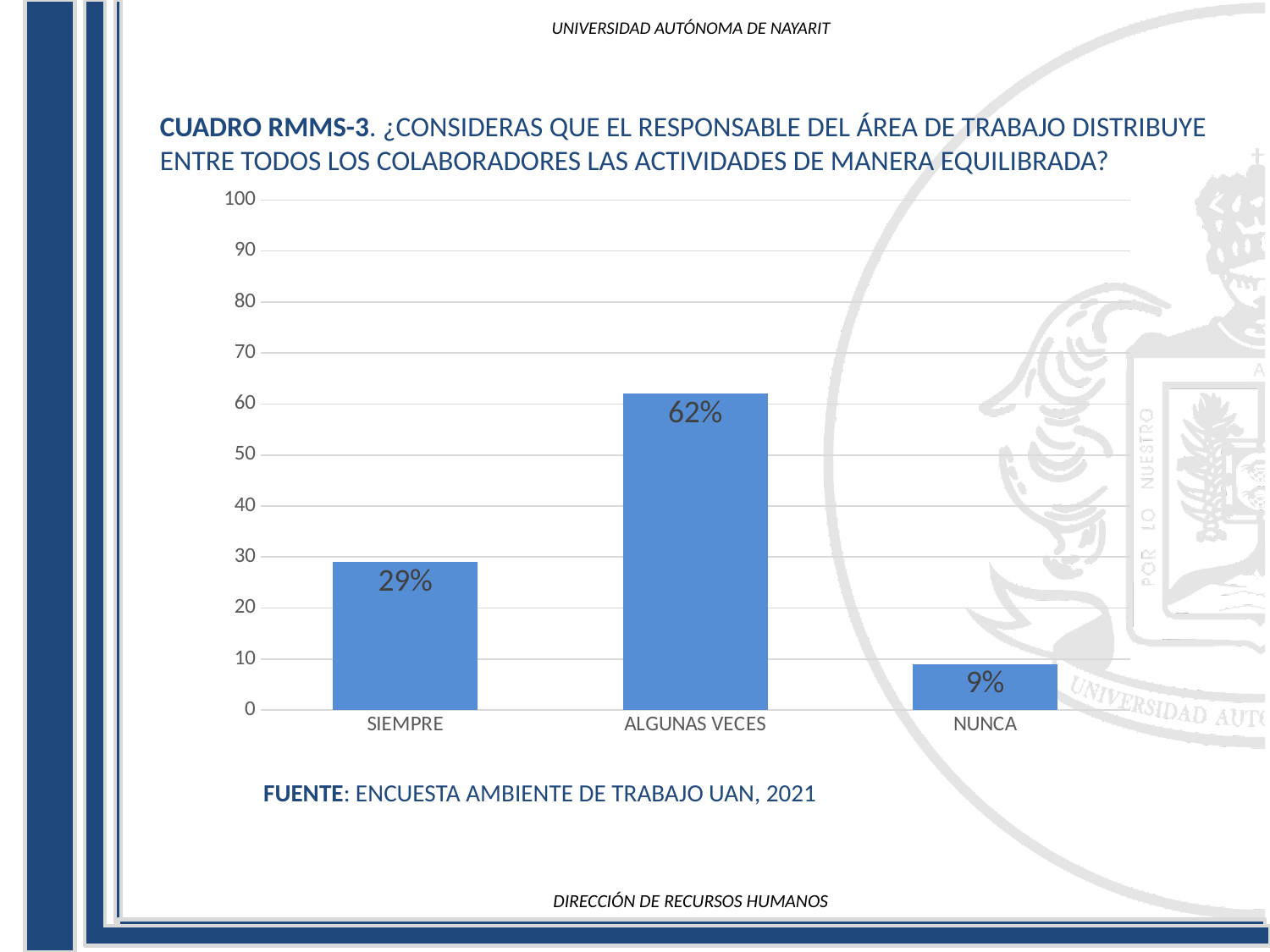
Which is larger, the value for SIEMPRE or the value for NUNCA? SIEMPRE What is the value for SIEMPRE? 29% What kind of chart is shown on the slide? bar chart What is the value for NUNCA? 9% Which category has the lowest value? NUNCA What source is cited below the chart? ENCUESTA AMBIENTE DE TRABAJO UAN, 2021 What is the value for ALGUNAS VECES? 62% What is the difference between the values for SIEMPRE and NUNCA? 20% What is the difference between the values for ALGUNAS VECES and SIEMPRE? 33% How many categories are shown on the x axis? 3 Which category has the highest value? ALGUNAS VECES Is the value for ALGUNAS VECES greater or less than 50? greater